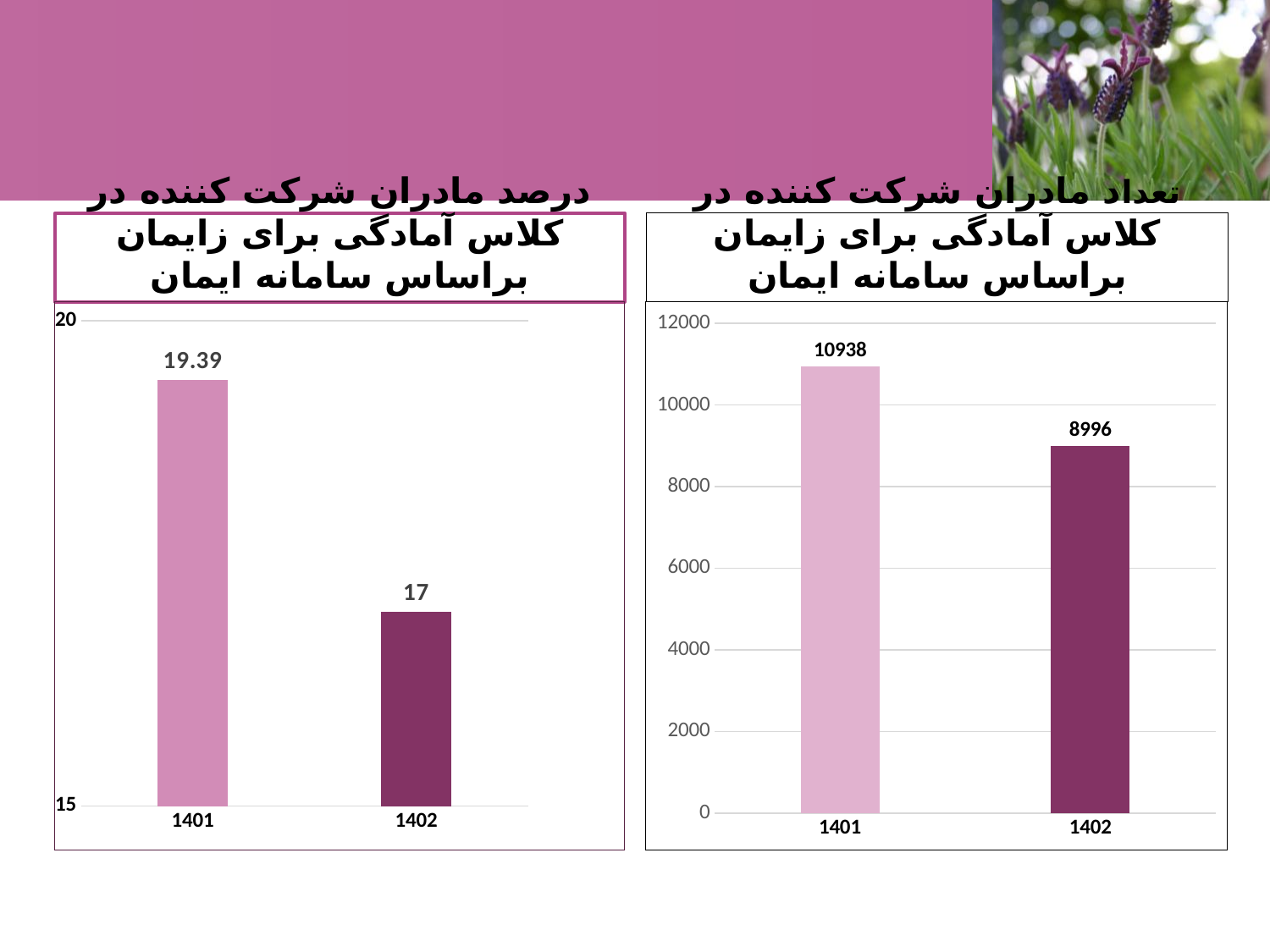
In the right-hand chart, is the value for 1402 greater or less than 10000? less What kind of chart is the left-hand chart? bar chart In the left-hand chart, what is the value for 1402? 17 In the left-hand chart, which year has the lowest value? 1402 In the right-hand chart, what is the difference between the values for 1401 and 1402? 1942 How many categories are shown on the x axis of the right-hand chart? 2 In the left-hand chart, what is the difference between the values for 1401 and 1402? 2.39 In the right-hand chart, what is the value for 1401? 10938 In the left-hand chart, what is the value for 1401? 19.39 In the right-hand chart, what is the value for 1402? 8996 In the right-hand chart, do the values rise or fall from 1401 to 1402? fall In the right-hand chart, which year has the highest value? 1401